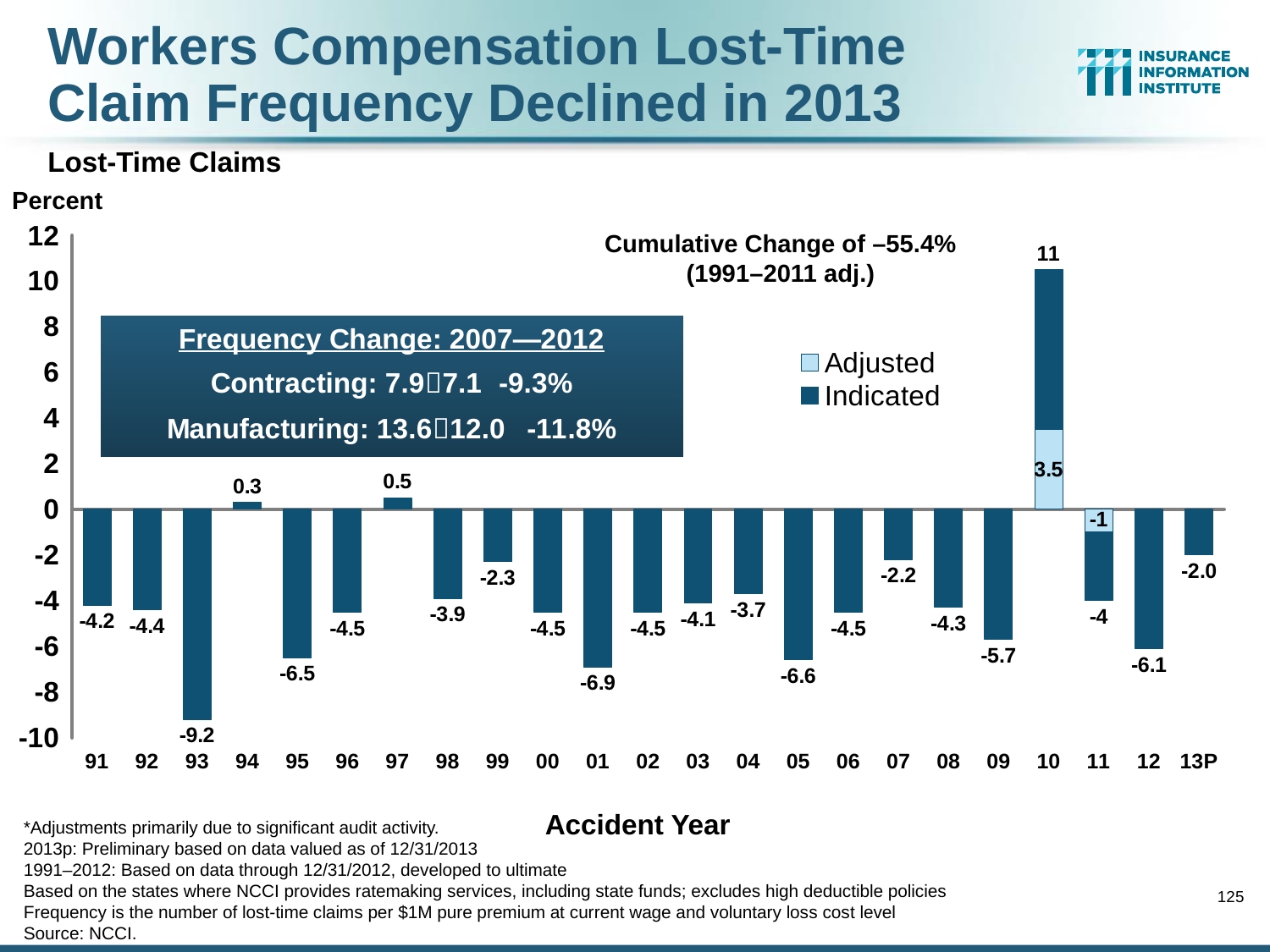
What is the difference between the values for accident years 93 and 12? 3.1 What is the Adjusted value for accident year 11? -1 What is the value for accident year 13P? -2.0 What is the value for accident year 93? -9.2 Which accident year has the lowest value? 93 Which is larger, the value for accident year 97 or accident year 94? 97 Which accident year has the highest value? 10 How many series does the legend list? 2 What cumulative change is stated on the chart for 1991–2011 adj.? –55.4% What is the Adjusted value for accident year 10? 3.5 What kind of chart is shown? bar chart How many accident years are shown on the x axis? 23